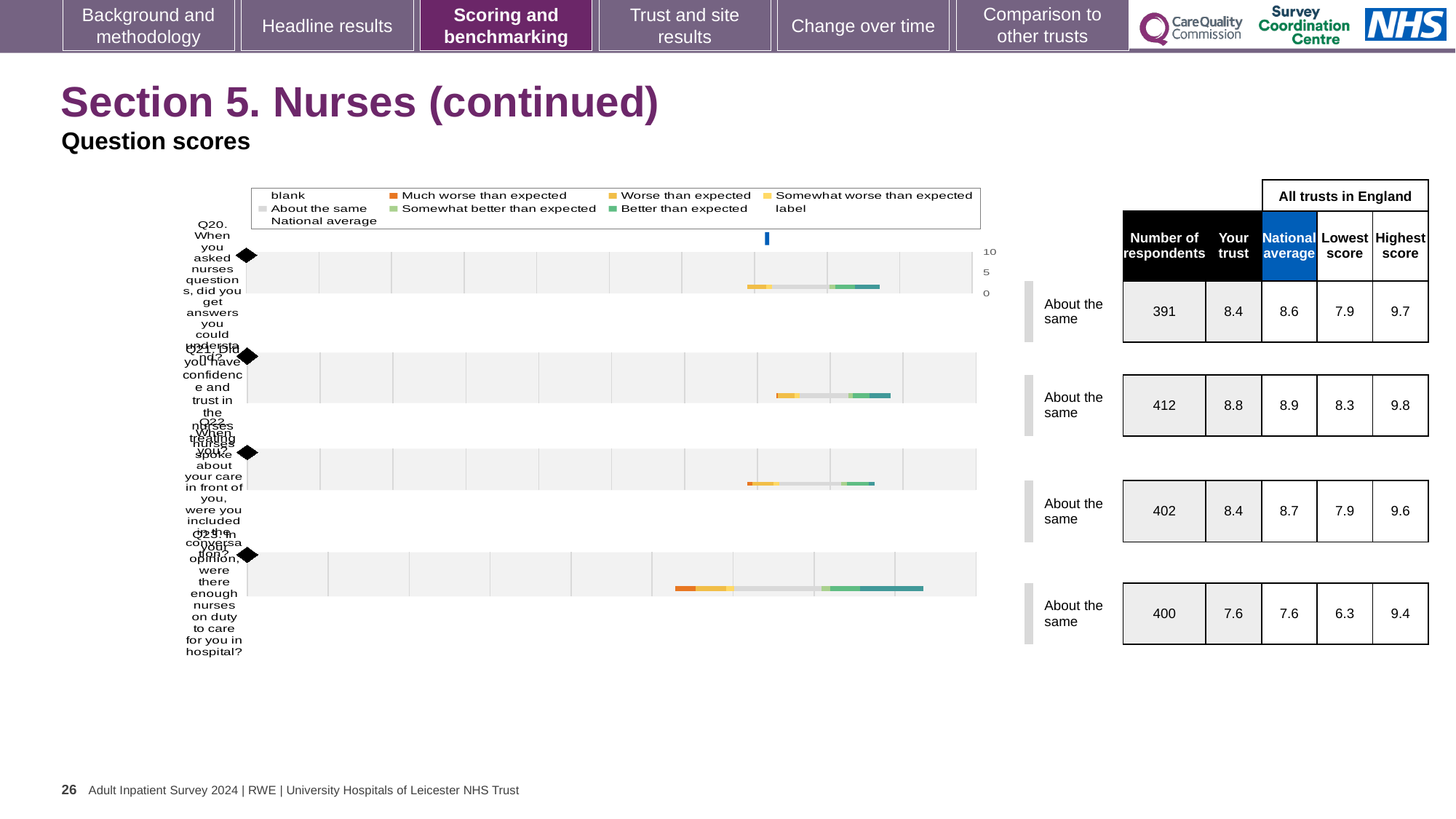
Which benchmark category is shown beside the bar for Q23 (enough nurses on duty)? About the same Which question's bar has the widest coloured benchmark band in the chart? Q23 How many entries does the chart legend list? 9 What kind of chart is used to show the question scores on this slide? bar chart In the table beside the chart, how many respondents answered Q21? 412 In the table beside the chart, what is the national average for Q23 (enough nurses on duty)? 7.6 In the table beside the chart, what is the 'Your trust' score for Q21 (confidence and trust in nurses)? 8.8 What colour does the legend use for 'Much worse than expected'? orange In the table beside the chart, which question has the lowest 'Your trust' score? Q23 In the table beside the chart, is the 'Your trust' score for Q22 larger or smaller than the national average? smaller In the table beside the chart, what is the difference between the highest score and lowest score for Q20? 1.8 How many questions (rows) are plotted in the chart? 4